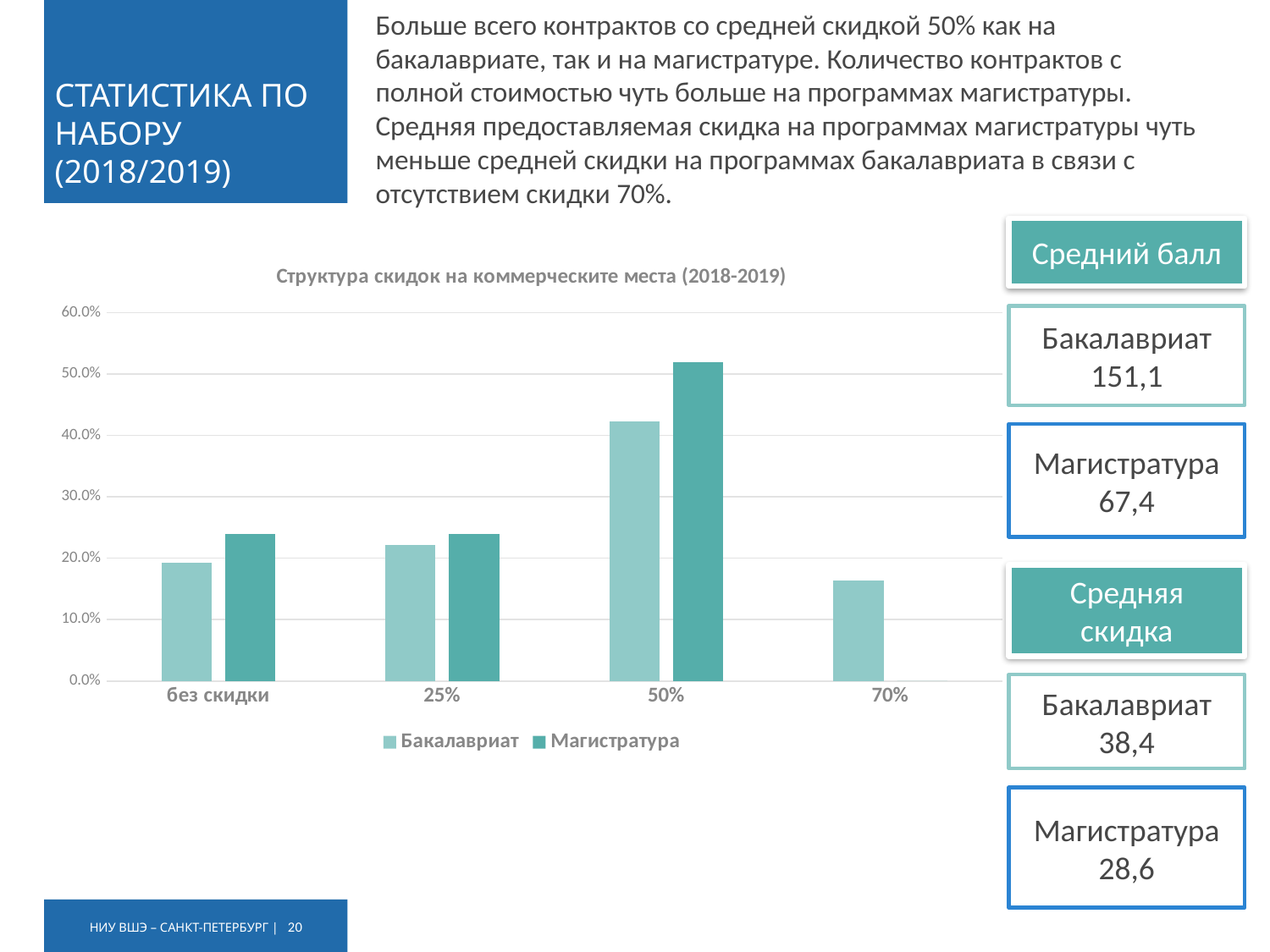
In the 50% category, which series has the larger value, Бакалавриат or Магистратура? Магистратура How many discount categories are shown on the x axis of the chart? 4 What kind of chart is shown on the slide? bar chart Which two series are listed in the chart legend? Бакалавриат and Магистратура For which discount category is the Бакалавриат bar the lowest? 70% Is the value for Бакалавриат in the 50% category greater or less than 30.0%? greater Is the value for Бакалавриат in the 70% category greater or less than 20.0%? less For which discount category is the Магистратура bar the highest? 50% For which discount category is the Бакалавриат bar the highest? 50% How many series does the chart legend list? 2 In the без скидки category, which series has the larger value, Бакалавриат or Магистратура? Магистратура What is the title of the chart? Структура скидок на коммерческите места (2018-2019)